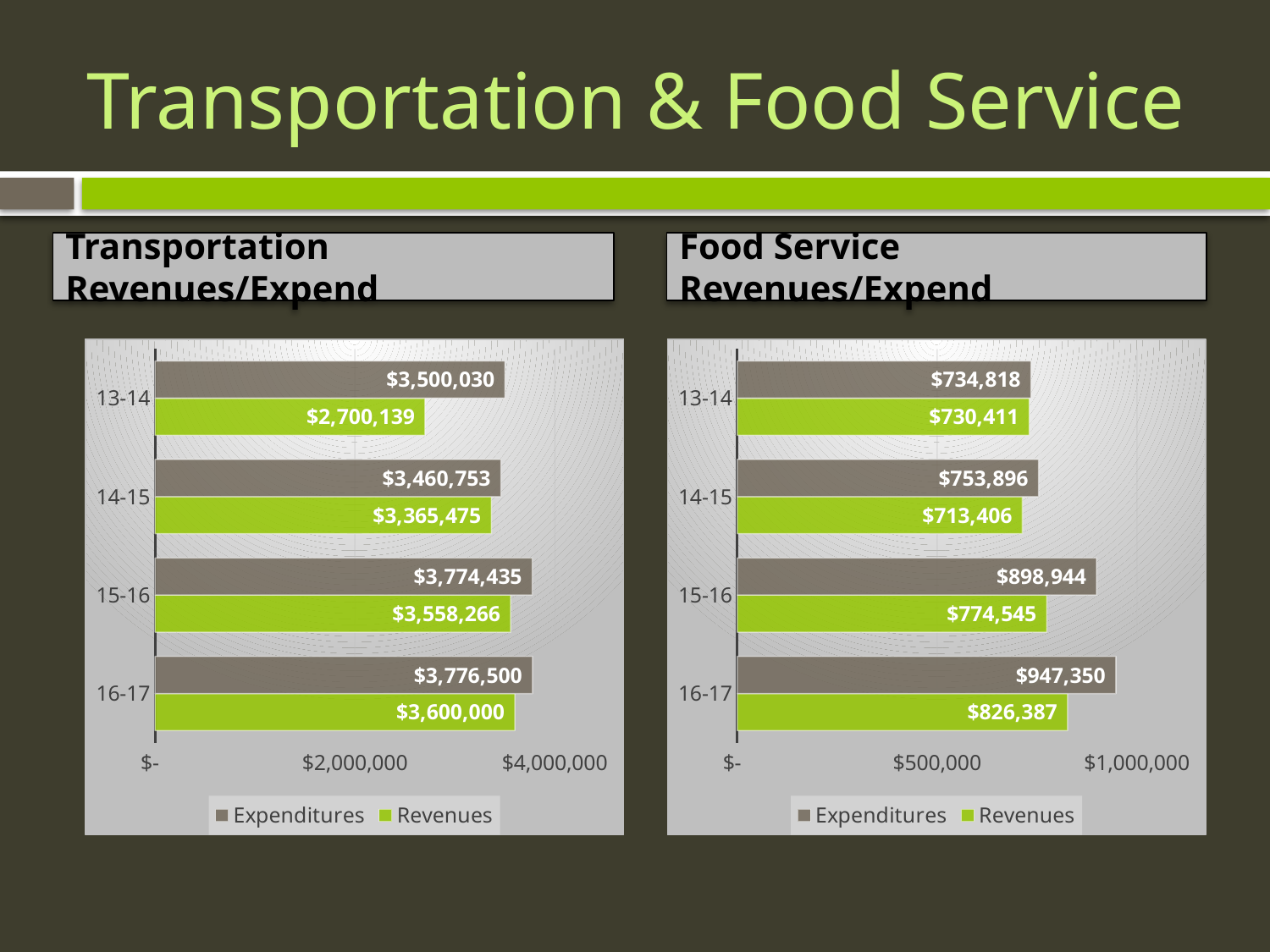
What type of chart is the Transportation Revenues/Expend chart? Bar chart In the Transportation Revenues/Expend chart, what are the Revenues for 13-14? $2,700,139 In the Food Service Revenues/Expend chart, what are the Expenditures for 15-16? $898,944 How many years are shown in the Transportation Revenues/Expend chart? 4 In the Food Service Revenues/Expend chart, which is larger for 14-15, Expenditures or Revenues? Expenditures In the Transportation Revenues/Expend chart, what is the difference between Expenditures and Revenues for 14-15? $95,278 In the Transportation Revenues/Expend chart, what are the Expenditures for 16-17? $3,776,500 In the Food Service Revenues/Expend chart, what are the Revenues for 16-17? $826,387 In the Transportation Revenues/Expend chart, which year has the lowest Revenues? 13-14 In the Food Service Revenues/Expend chart, which year has the highest Expenditures? 16-17 How many series does the legend of the Food Service Revenues/Expend chart list? 2 In the Food Service Revenues/Expend chart, what is the difference between Expenditures and Revenues for 16-17? $120,963